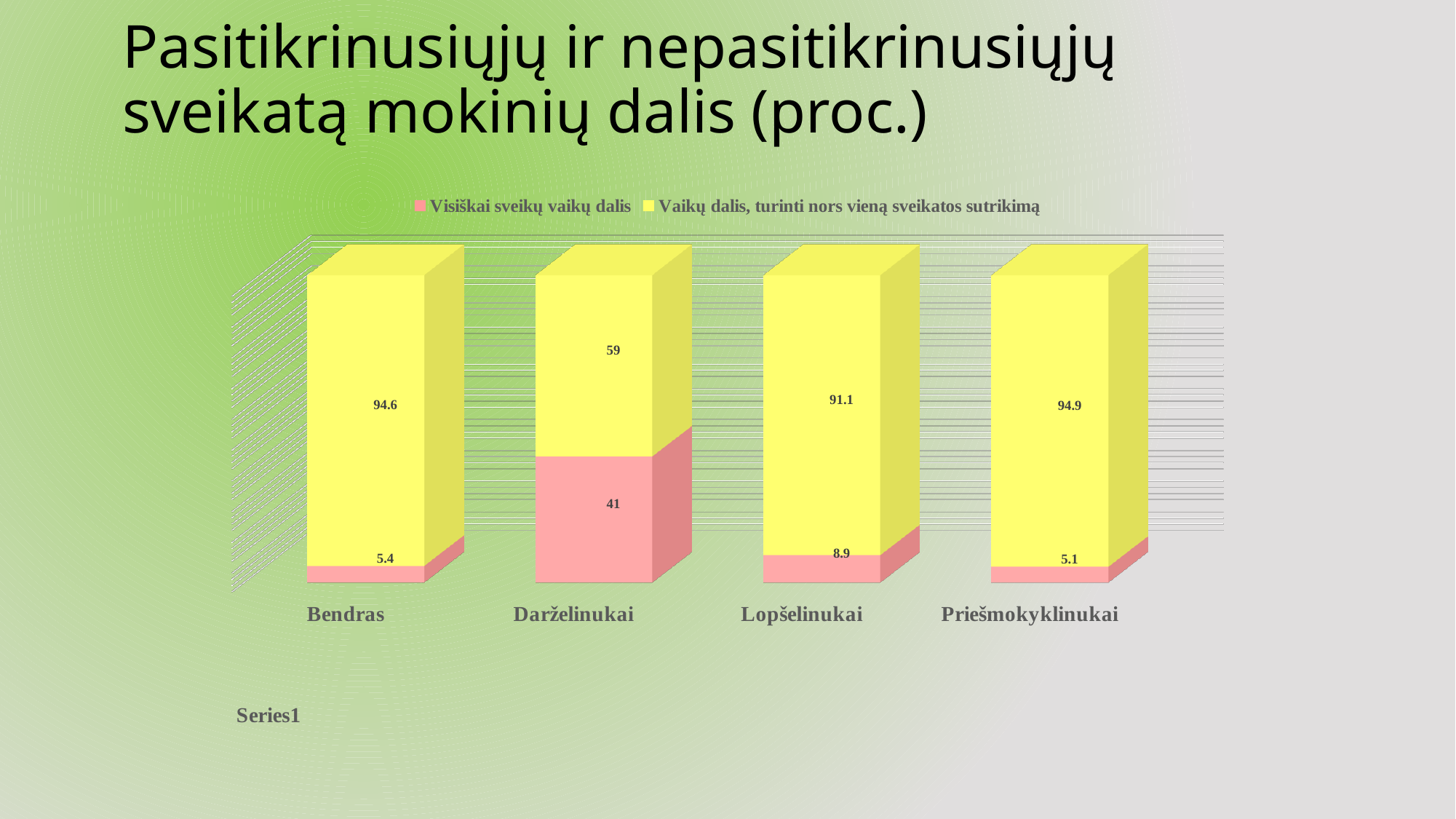
What is the value of 'Visiškai sveikų vaikų dalis' for Darželinukai? 41 What kind of chart is shown on the slide? Stacked bar chart Which category has the highest value for 'Visiškai sveikų vaikų dalis'? Darželinukai How many categories are shown on the x axis? 4 What is the value of 'Vaikų dalis, turinti nors vieną sveikatos sutrikimą' for Priešmokyklinukai? 94.9 What is the difference between the 'Vaikų dalis, turinti nors vieną sveikatos sutrikimą' values for Priešmokyklinukai and Lopšelinukai? 3.8 What is the total of the stacked bar for Darželinukai? 100 Which is larger: 'Visiškai sveikų vaikų dalis' for Lopšelinukai or for Bendras? Lopšelinukai What is the value of 'Vaikų dalis, turinti nors vieną sveikatos sutrikimą' for Bendras? 94.6 How many series does the legend list? 2 What is the value of 'Visiškai sveikų vaikų dalis' for Lopšelinukai? 8.9 Which category has the lowest value for 'Vaikų dalis, turinti nors vieną sveikatos sutrikimą'? Darželinukai